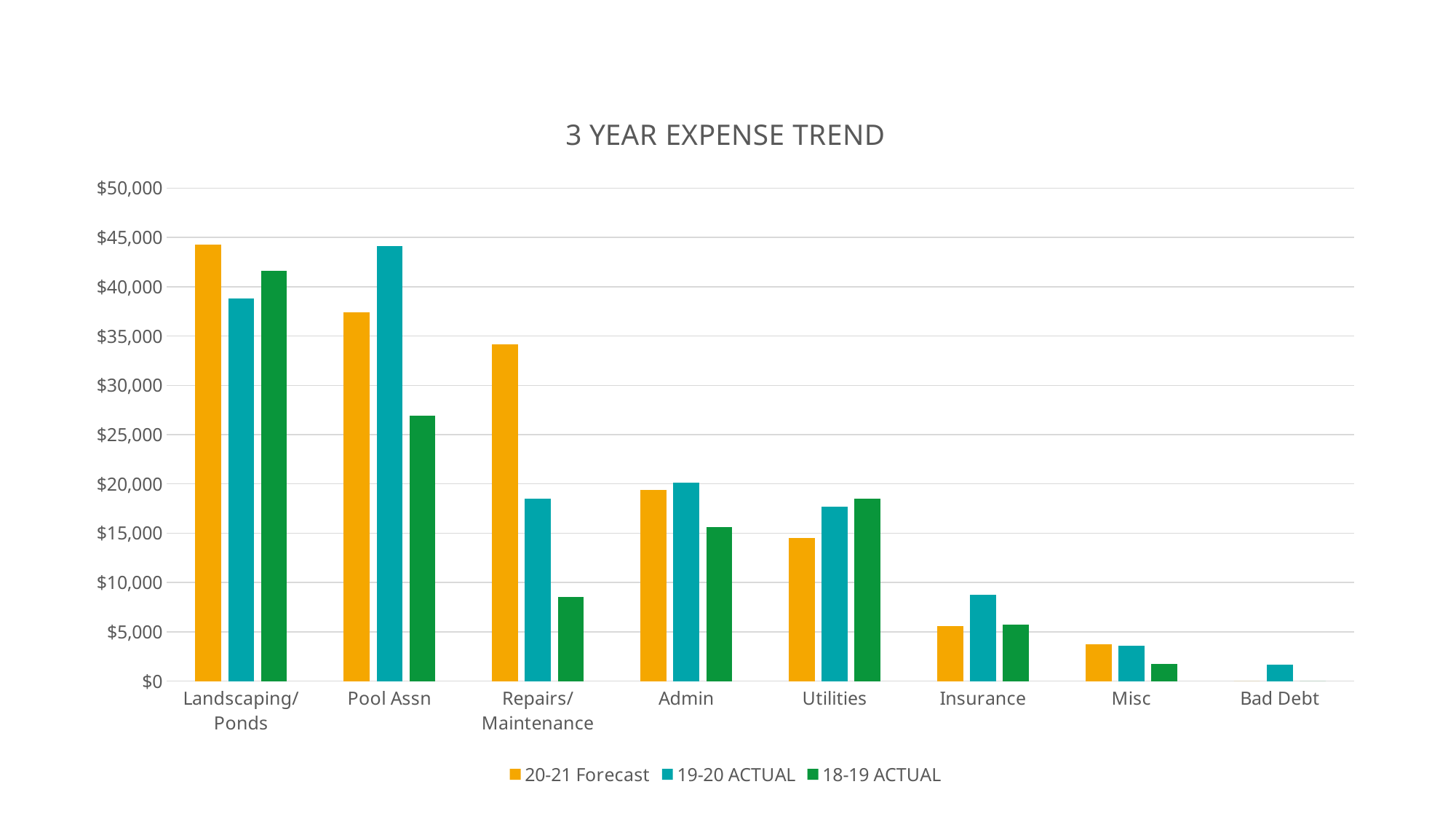
How many expense categories are shown on the x axis? 8 For Pool Assn, which is larger: the 19-20 ACTUAL value or the 18-19 ACTUAL value? 19-20 ACTUAL Is the 20-21 Forecast value for Repairs/Maintenance greater or less than $30,000? greater Which category has the highest 20-21 Forecast value? Landscaping/Ponds What kind of chart is shown on the slide? Bar chart Which category has the highest 19-20 ACTUAL value? Pool Assn Is the 19-20 ACTUAL value for Insurance greater or less than $10,000? less Which category has the lowest 19-20 ACTUAL value? Bad Debt Is the 18-19 ACTUAL value for Pool Assn greater or less than $25,000? greater What is the title of the chart? 3 YEAR EXPENSE TREND For Utilities, which is larger: the 20-21 Forecast value or the 18-19 ACTUAL value? 18-19 ACTUAL How many series does the legend list? 3